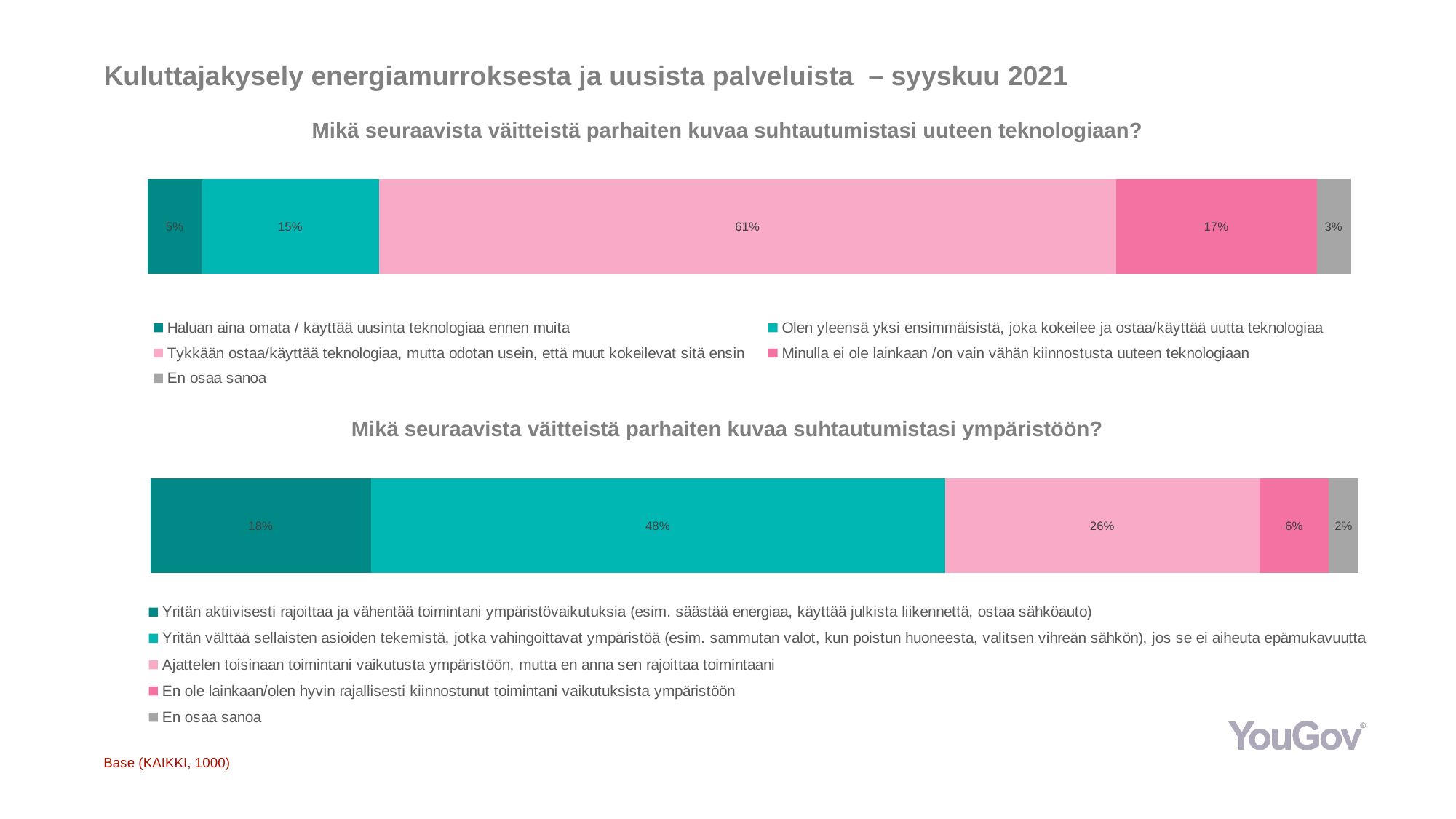
In the bottom chart (suhtautumistasi ympäristöön), what percentage chose "Yritän välttää sellaisten asioiden tekemistä, jotka vahingoittavat ympäristöä..."? 48% In the bottom chart (suhtautumistasi ympäristöön), what percentage chose "Yritän aktiivisesti rajoittaa ja vähentää toimintani ympäristövaikutuksia..."? 18% In the top chart (suhtautumistasi uuteen teknologiaan), what percentage chose "Tykkään ostaa/käyttää teknologiaa, mutta odotan usein, että muut kokeilevat sitä ensin"? 61% In the top chart (suhtautumistasi uuteen teknologiaan), which statement has the largest share? Tykkään ostaa/käyttää teknologiaa, mutta odotan usein, että muut kokeilevat sitä ensin In the bottom chart (suhtautumistasi ympäristöön), which statement has the smallest share? En osaa sanoa In the bottom chart (suhtautumistasi ympäristöön), what is the difference between the 48% segment and the 26% segment? 22% In the top chart (suhtautumistasi uuteen teknologiaan), what percentage chose "Haluan aina omata / käyttää uusinta teknologiaa ennen muita"? 5% In the top chart (suhtautumistasi uuteen teknologiaan), what percentage answered "En osaa sanoa"? 3% How many series does the legend of the top chart (suhtautumistasi uuteen teknologiaan) list? 5 In the bottom chart (suhtautumistasi ympäristöön), which is larger: "Ajattelen toisinaan toimintani vaikutusta ympäristöön..." or "En ole lainkaan/olen hyvin rajallisesti kiinnostunut..."? Ajattelen toisinaan toimintani vaikutusta ympäristöön, mutta en anna sen rajoittaa toimintaani In the top chart (suhtautumistasi uuteen teknologiaan), what is the difference between "Minulla ei ole lainkaan /on vain vähän kiinnostusta uuteen teknologiaan" and "Olen yleensä yksi ensimmäisistä, joka kokeilee ja ostaa/käyttää uutta teknologiaa"? 2% What type of chart is used for both charts on the slide? Stacked bar chart